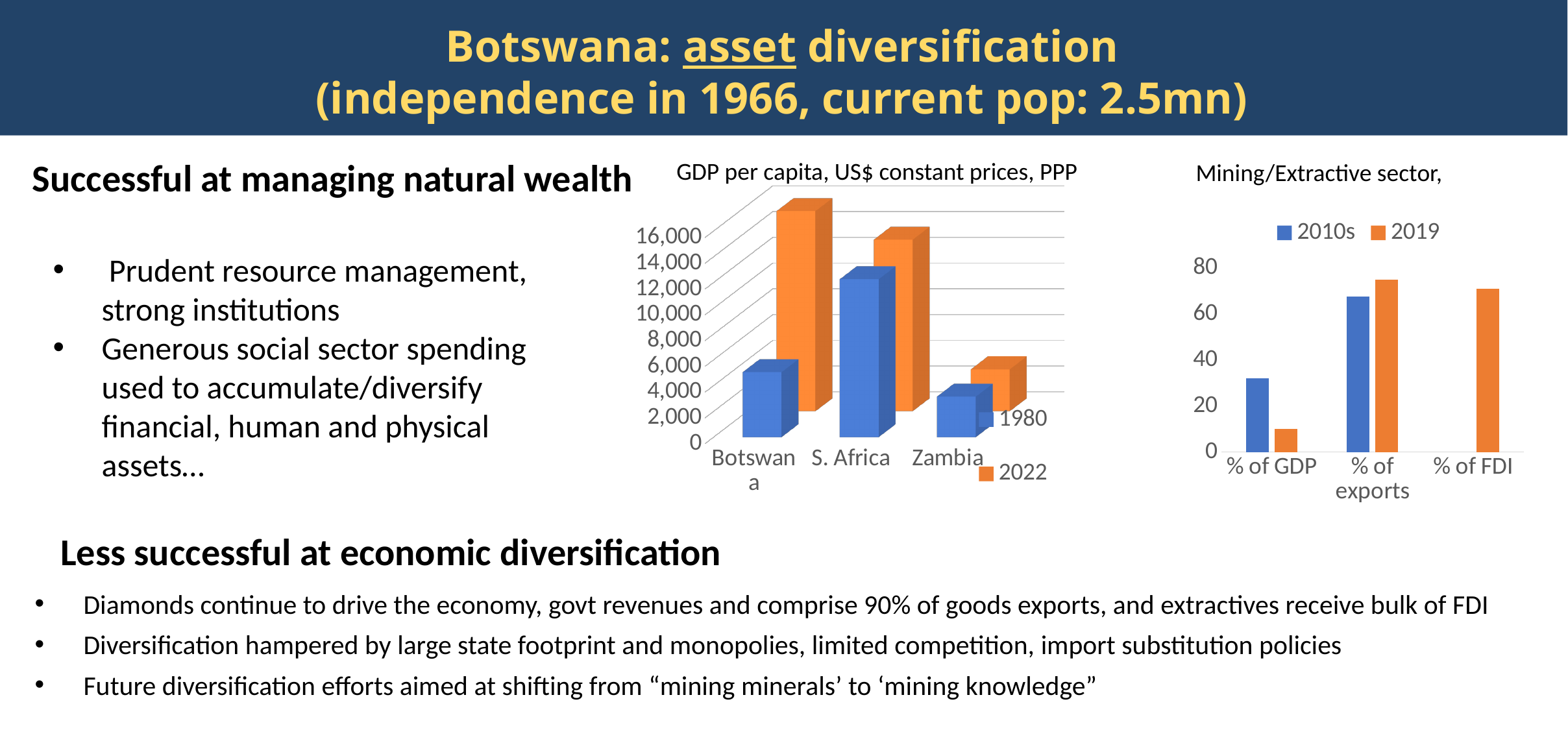
On the 'GDP per capita, US$ constant prices, PPP' chart, which country has the lowest 1980 value? Zambia On the 'GDP per capita, US$ constant prices, PPP' chart, which country has the highest 2022 value? Botswana On the 'Mining/Extractive sector' chart, which category has the lowest 2019 value? % of GDP How many countries are shown on the 'GDP per capita, US$ constant prices, PPP' chart? 3 On the 'Mining/Extractive sector' chart, is the 2010s value for % of GDP greater or less than 20? greater On the 'Mining/Extractive sector' chart, is the 2019 value for % of GDP greater or less than 20? less On the 'Mining/Extractive sector' chart, which series does the legend list besides 2019? 2010s What kind of chart is the 'GDP per capita, US$ constant prices, PPP' chart? bar chart How many categories are shown on the 'Mining/Extractive sector' chart? 3 On the 'GDP per capita, US$ constant prices, PPP' chart, which is larger for 1980: Botswana or S. Africa? S. Africa How many series does the legend of the 'GDP per capita, US$ constant prices, PPP' chart list? 2